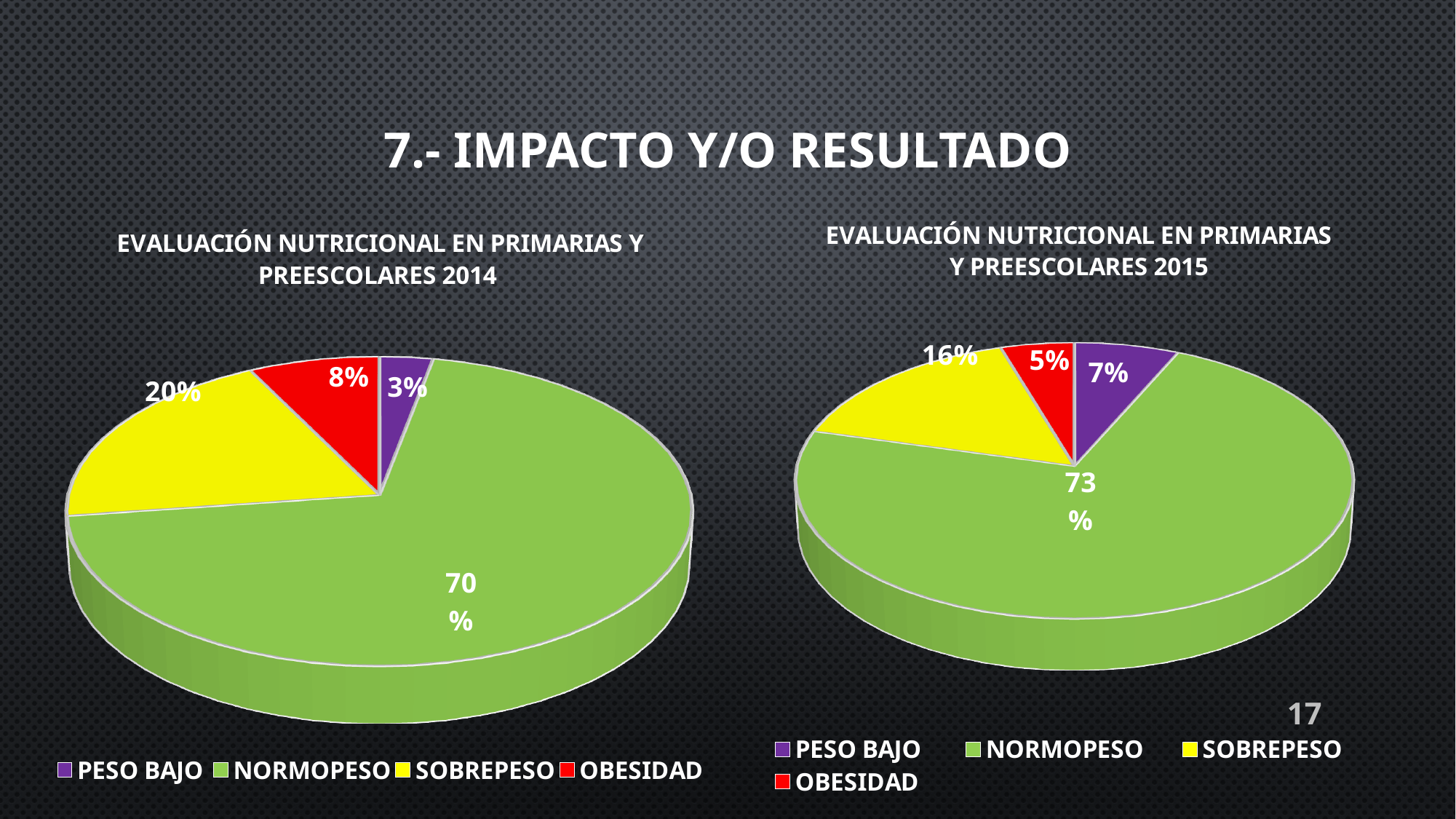
In the 2015 chart (right), what share does PESO BAJO have? 7% What type of chart is the 2014 chart (left)? Pie chart In the 2015 chart (right), what is the difference between SOBREPESO and OBESIDAD? 11% In the 2014 chart (left), what share does SOBREPESO have? 20% In the 2015 chart (right), which colour represents OBESIDAD? Red In the 2015 chart (right), which category has the largest slice? NORMOPESO Which is larger in the 2014 chart (left): SOBREPESO or OBESIDAD? SOBREPESO In the 2014 chart (left), what share does OBESIDAD have? 8% How many categories does the 2015 chart (right) show? 4 In the 2015 chart (right), what share does NORMOPESO have? 73% In the 2014 chart (left), which category has the smallest slice? PESO BAJO In the 2014 chart (left), what share does NORMOPESO have? 70%